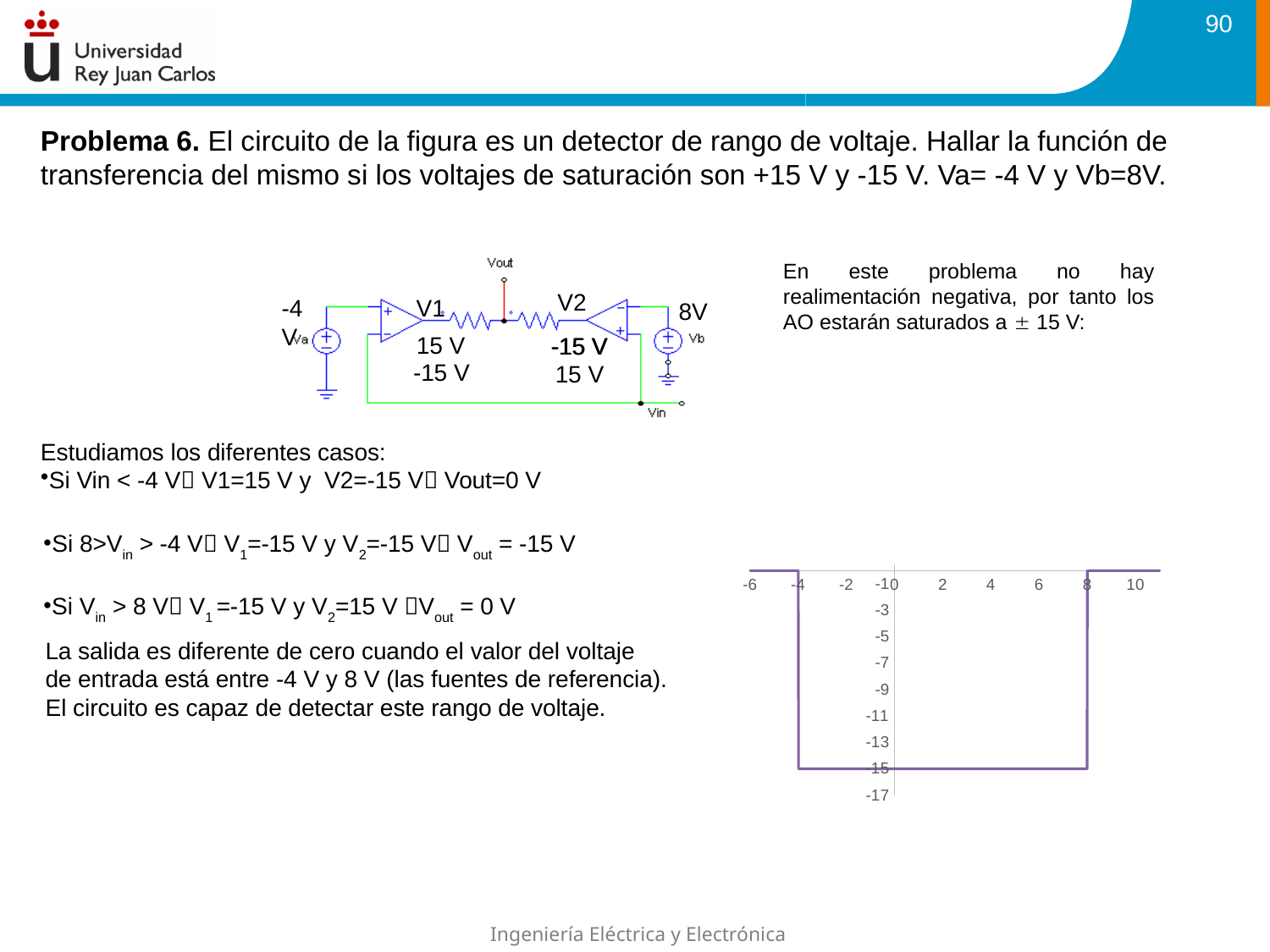
In the chart at the bottom right, is the value of the line at x = 4 greater or less than -13? less In the chart at the bottom right, what is the lowest tick label on the y axis? -17 In the chart at the bottom right, at which x value does the line drop from the top level down to -15? -4 In the chart at the bottom right, at which x value does the line return from -15 back up to the top level? 8 In the chart at the bottom right, how many tick labels are shown on the x axis? 9 In the chart at the bottom right, does the line rise, fall or stay flat between x = -2 and x = 6? stays flat In the chart at the bottom right, what is the highest tick label on the x axis? 10 In the chart at the bottom right, what is the value of the line at x = 0? -15 In the chart at the bottom right, what is the value of the line at x = 2? -15 In the chart at the bottom right, is the value of the line at x = 10 greater or less than -3? greater In the chart at the bottom right, is the value of the line at x = -6 greater or less than -5? greater What kind of chart is shown at the bottom right of the slide? line chart